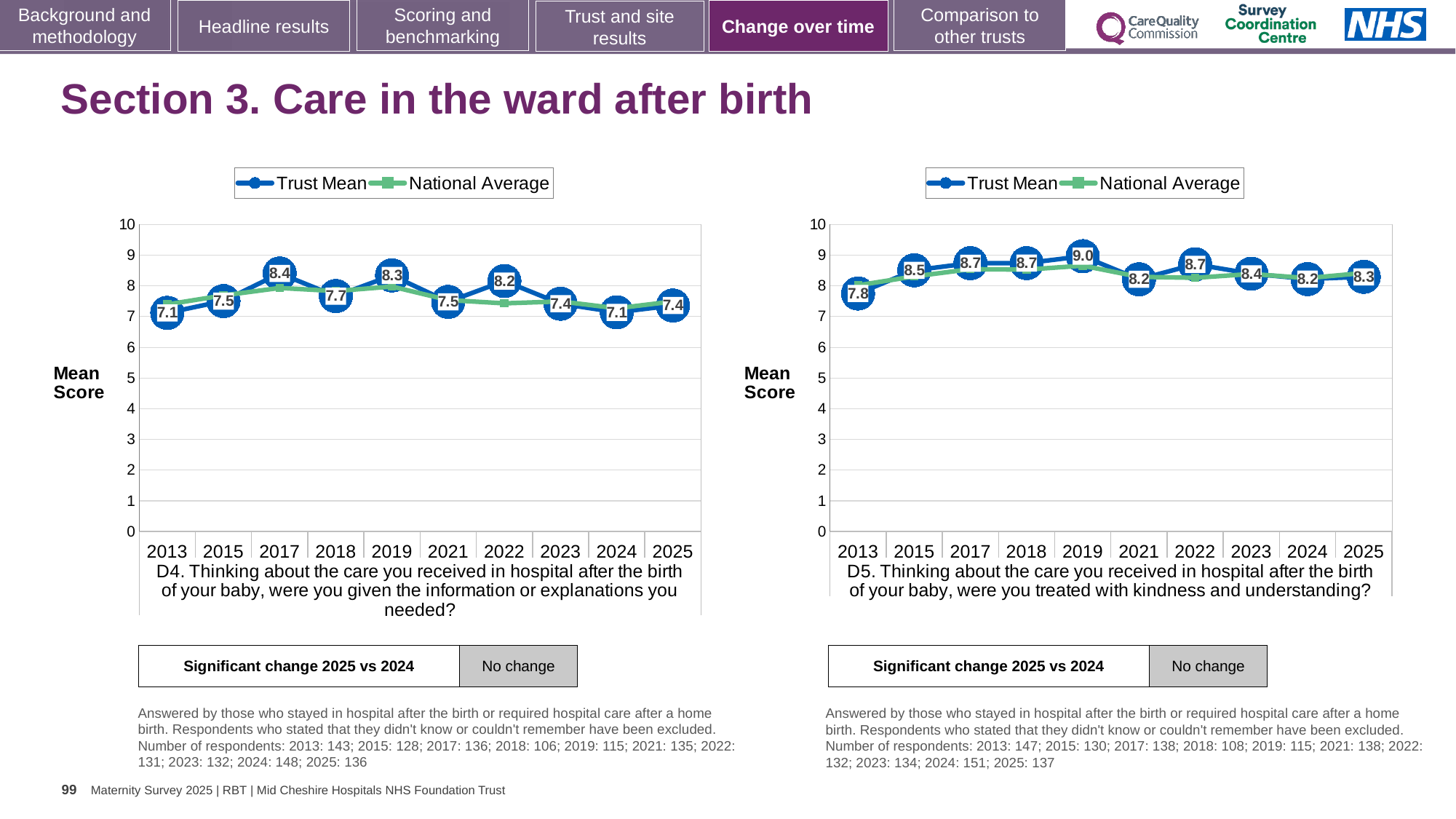
On the D4 chart (left), what is the Trust Mean score for 2025? 7.4 On the D5 chart (right), in which year is the Trust Mean lowest? 2013 What type of chart is the D5 chart (right)? Line chart How many series does the legend of the D4 chart (left) list? 2 On the D4 chart (left), in which year is the Trust Mean highest? 2017 On the D5 chart (right), in which year is the Trust Mean highest? 2019 How many years are plotted on the D5 chart (right)? 10 On the D5 chart (right), which year has the larger Trust Mean, 2015 or 2021? 2015 On the D4 chart (left), what is the difference between the Trust Mean in 2017 and in 2018? 0.7 On the D5 chart (right), what is the Trust Mean score for 2019? 9.0 On the D4 chart (left), is the Trust Mean for 2024 greater or less than 8? less On the D4 chart (left), what is the Trust Mean score for 2017? 8.4